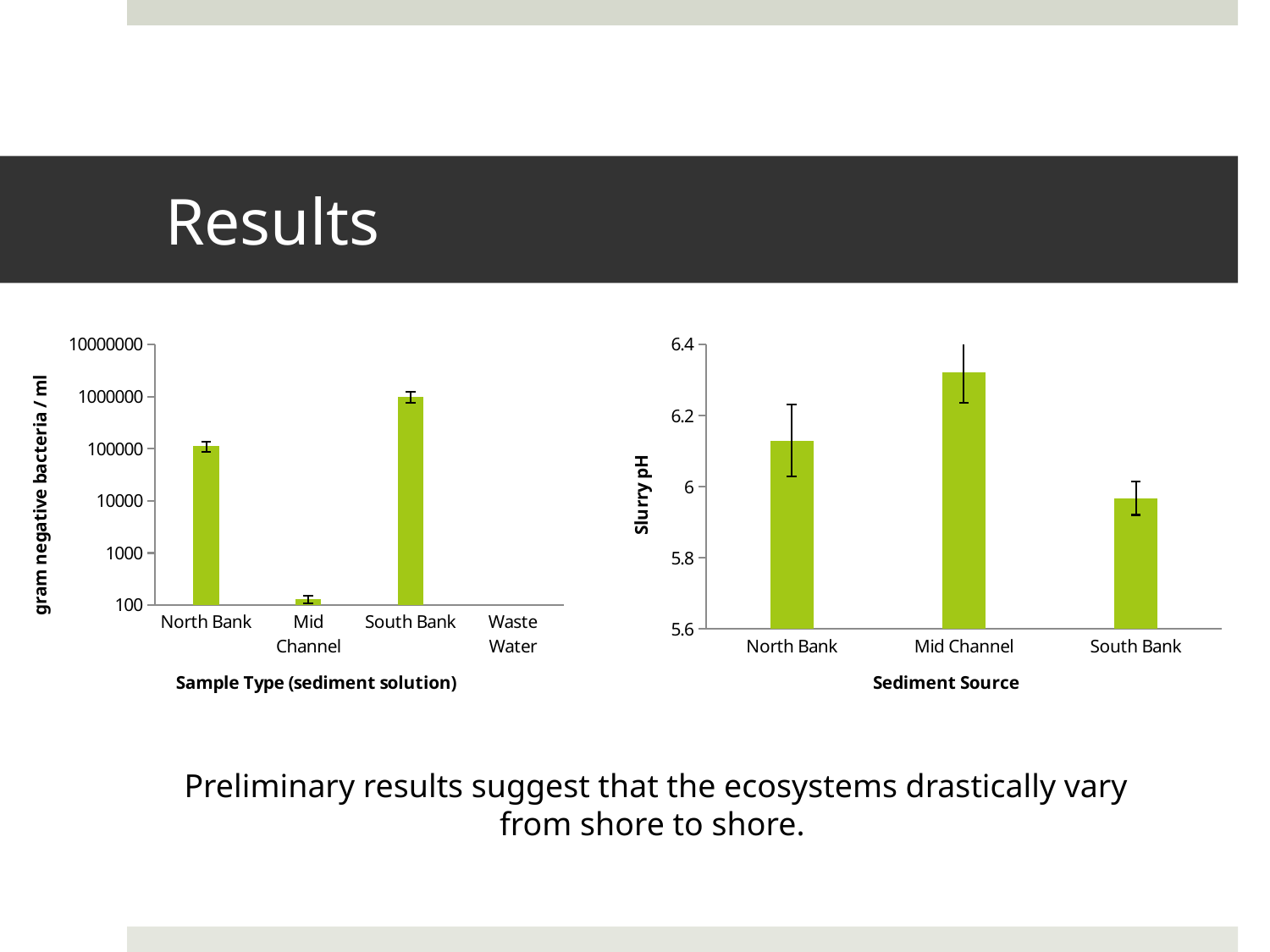
On the left chart (gram negative bacteria / ml), which sample type with a visible bar has the lowest value? Mid Channel What kind of chart is the right chart (Slurry pH)? Bar chart On the right chart (Slurry pH), which sediment source has the highest pH? Mid Channel On the left chart (gram negative bacteria / ml), which is larger, North Bank or Mid Channel? North Bank What is the x-axis title of the left chart? Sample Type (sediment solution) On the right chart (Slurry pH), is the value for Mid Channel greater or less than 6.2? greater On the left chart (gram negative bacteria / ml), which sample type has the highest bar? South Bank On the left chart (gram negative bacteria / ml), is the value for South Bank greater or less than 100000? greater On the right chart (Slurry pH), which sediment source has the lowest pH? South Bank On the left chart (gram negative bacteria / ml), is the value for Mid Channel greater or less than 1000? less How many sample types are labelled on the x axis of the left chart (gram negative bacteria / ml)? 4